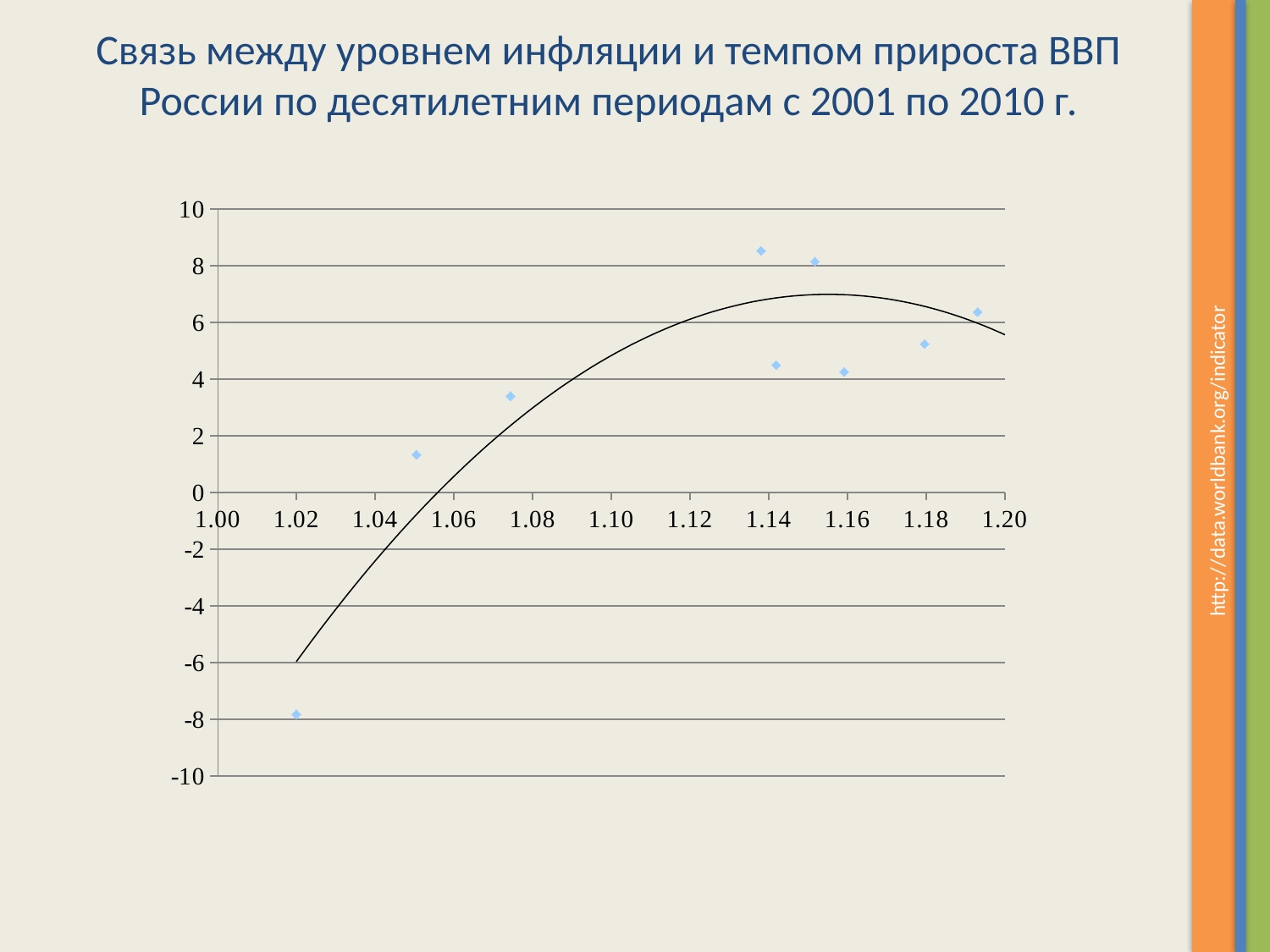
Is the value of the highest point on the chart greater or less than 8? greater Do the plotted points generally rise or fall as the x value increases from 1.02 to 1.14? rise Is the value of the point near x = 1.18 greater or less than 6? less Is the value of the point near x = 1.02 greater or less than 0? less What is the title of the chart on the slide? Связь между уровнем инфляции и темпом прироста ВВП России по десятилетним периодам с 2001 по 2010 г. Which is larger: the value of the point near x = 1.02 or the value of the point near x = 1.05? the point near x = 1.05 What kind of chart is shown on the slide? scatter chart What is the minimum value shown on the vertical axis? -10 What is the maximum value shown on the vertical axis? 10